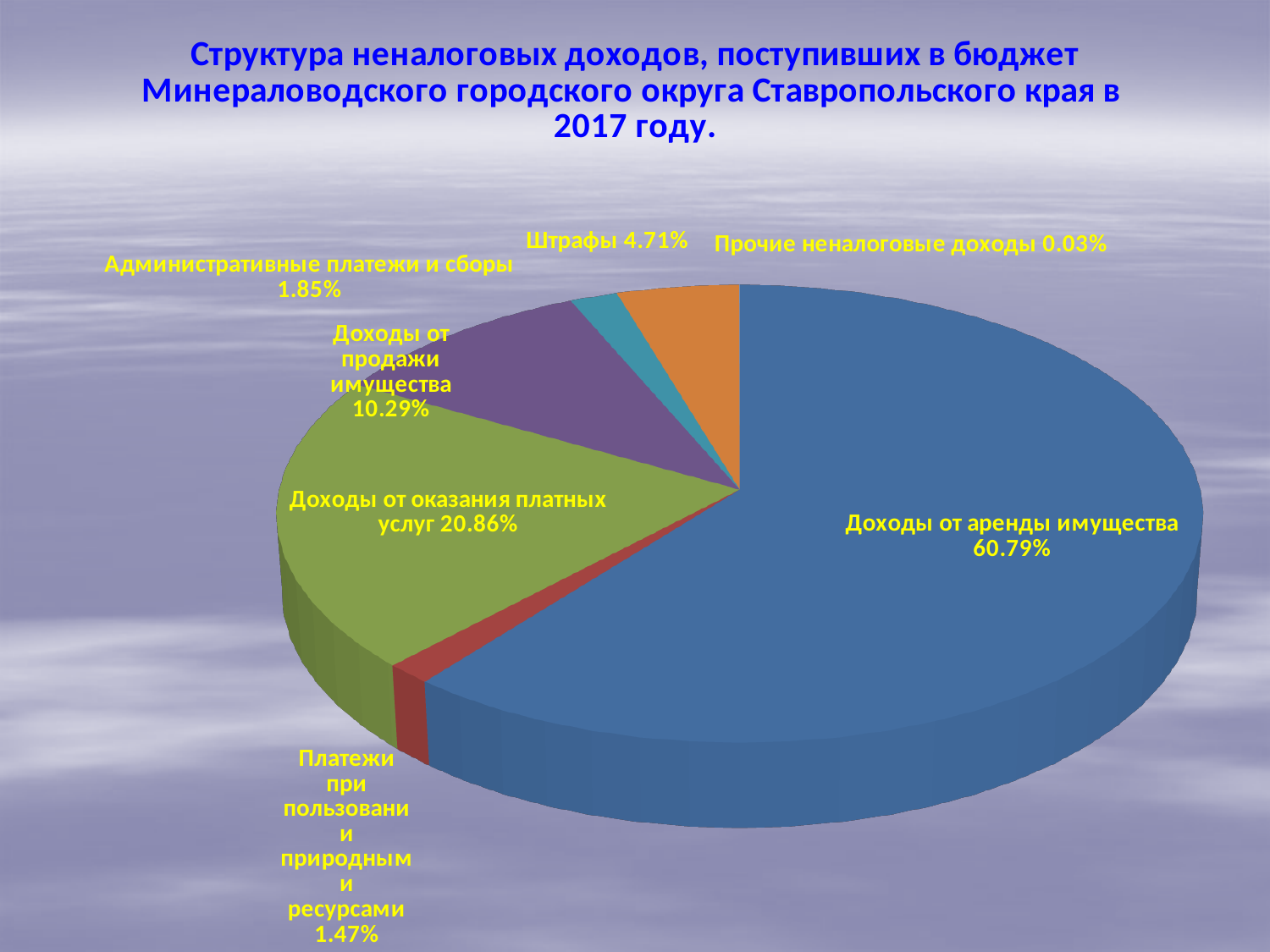
What is the difference between the shares of "Доходы от аренды имущества" and "Доходы от оказания платных услуг"? 39.93% What is the value for "Платежи при пользовании природными ресурсами"? 1.47% Which is larger: "Административные платежи и сборы" or "Платежи при пользовании природными ресурсами"? Административные платежи и сборы What percentage is shown for "Штрафы"? 4.71% What is the value shown for "Доходы от оказания платных услуг"? 20.86% What kind of chart is shown on the slide? Pie chart Which category has the largest slice of the pie? Доходы от аренды имущества What is the combined share of "Доходы от продажи имущества" and "Штрафы"? 15.00% Which category has the smallest slice of the pie? Прочие неналоговые доходы Which year does the chart title say the data refers to? 2017 How many categories are shown in the pie chart? 7 What share of non-tax revenue comes from "Доходы от аренды имущества"? 60.79%